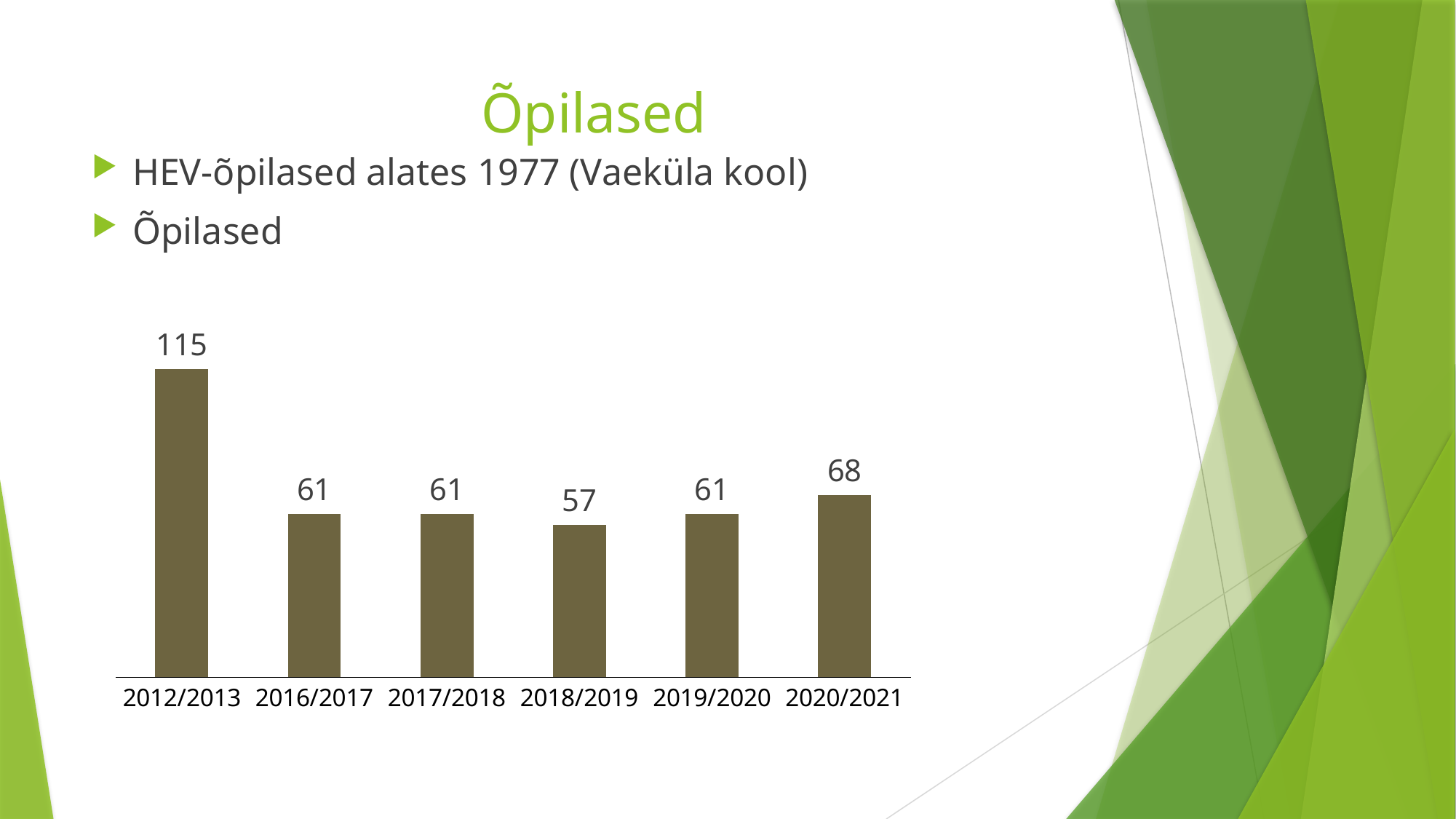
What is the value for 2012/2013? 115 What is the difference between the values for 2012/2013 and 2020/2021? 47 What is the value for 2016/2017? 61 Which category has the highest value? 2012/2013 Do the values rise or fall from 2018/2019 to 2020/2021? rise What is the difference between the values for 2019/2020 and 2018/2019? 4 What kind of chart is shown on the slide? bar chart How many categories are shown on the x axis? 6 What is the value for 2020/2021? 68 Which category has the lowest value? 2018/2019 Which is larger, the value for 2020/2021 or the value for 2017/2018? 2020/2021 What is the value for 2018/2019? 57